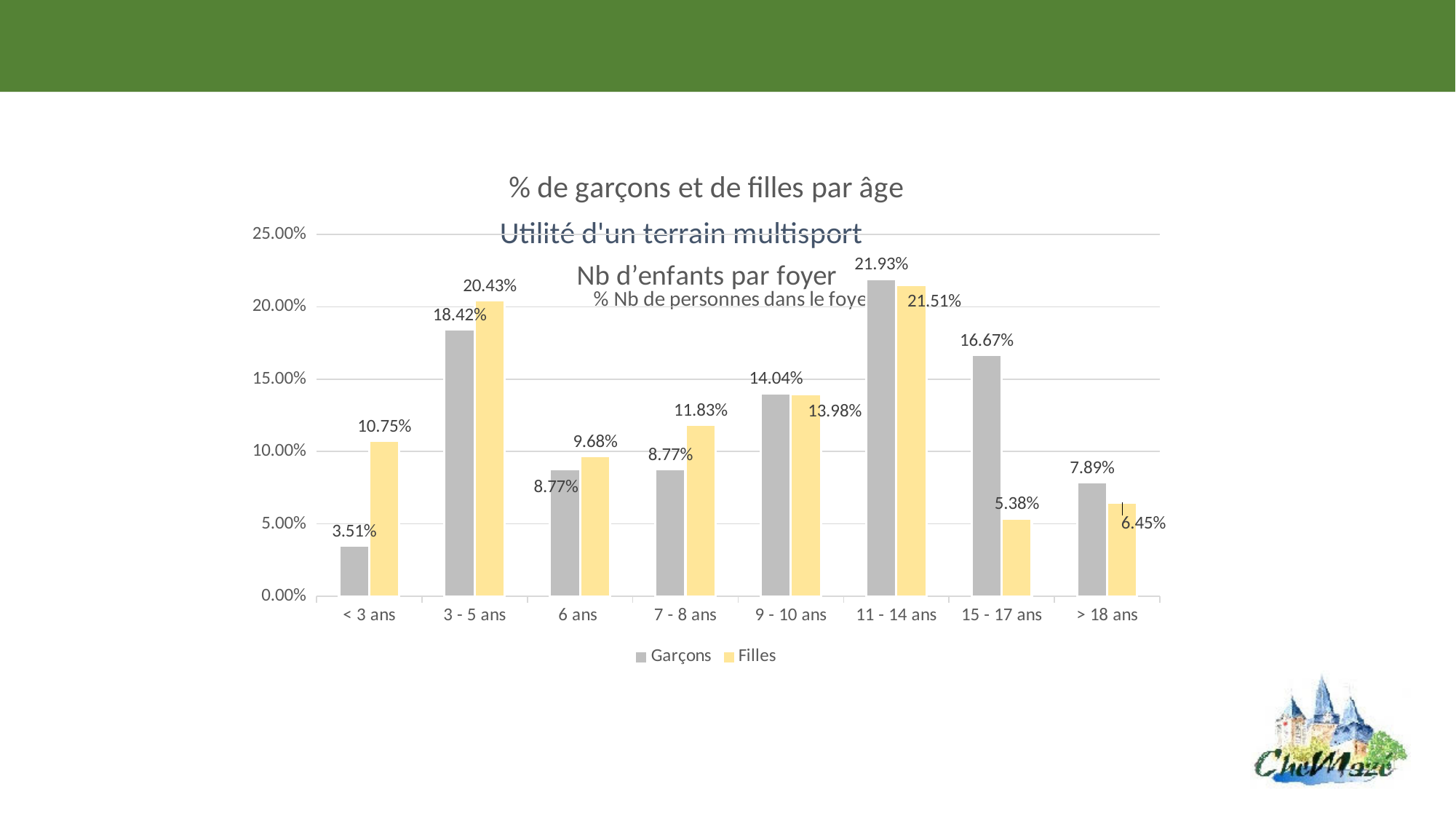
What is the difference between Garçons and Filles in the '15 - 17 ans' category? 11.29% How many age categories are shown on the x axis? 8 What is the value for Filles in the '3 - 5 ans' category? 20.43% How many series does the legend list? 2 In the '< 3 ans' category, which is larger, Garçons or Filles? Filles Is the value for Garçons in the '3 - 5 ans' category greater or less than 15.00%? greater What is the value for Garçons in the '< 3 ans' category? 3.51% Which age category has the lowest value for Filles? 15 - 17 ans What is the value for Filles in the '15 - 17 ans' category? 5.38% Which age category has the highest value for Garçons? 11 - 14 ans What colour are the bars for the Filles series? yellow What type of chart is shown on the slide? bar chart